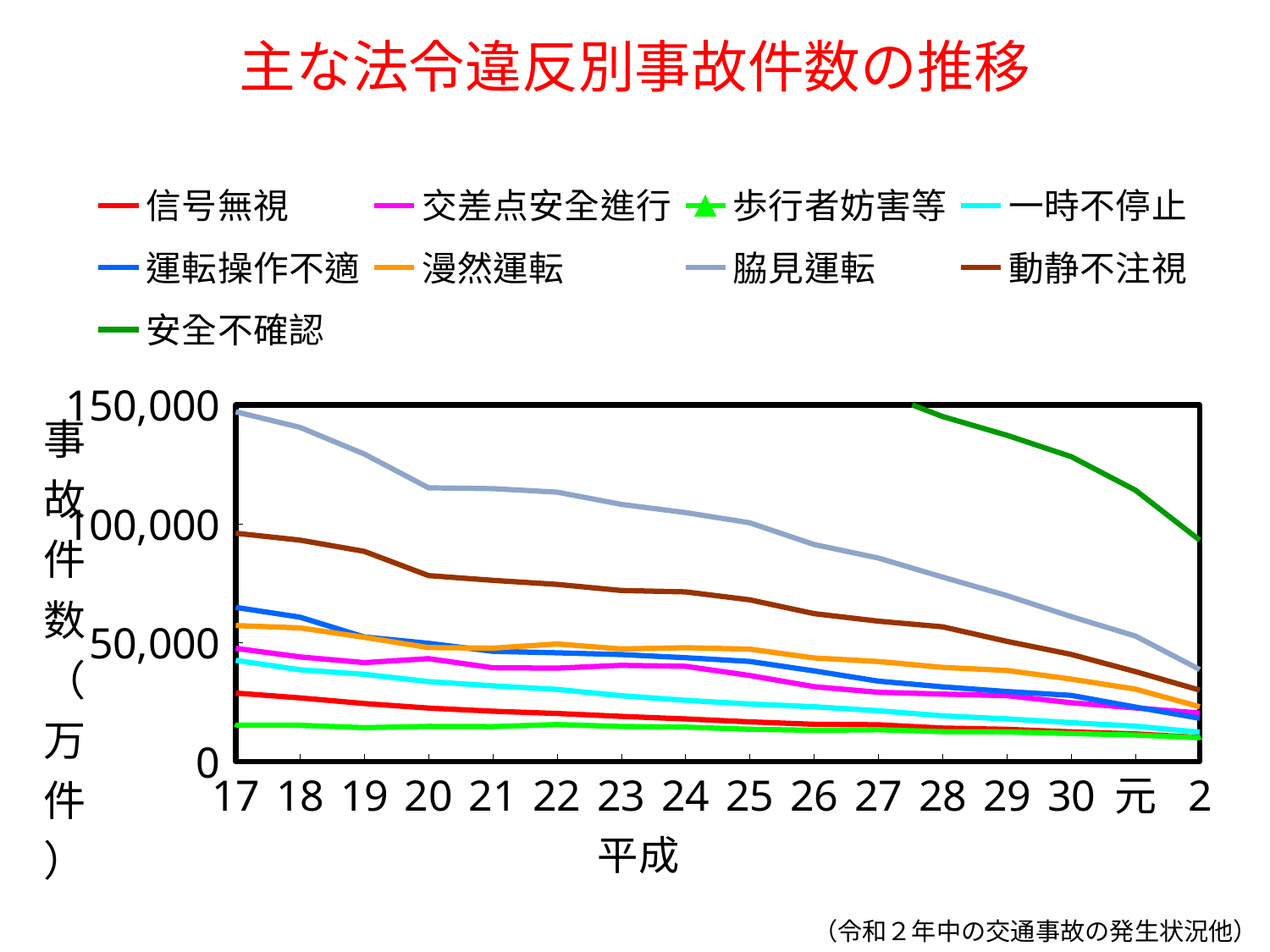
How many points are marked along the x axis? 16 Is the value for 安全不確認 in 平成30 greater or less than 100,000? greater Is the value for 運転操作不適 in 平成17 greater or less than 50,000? greater In 平成17, which is larger, 脇見運転 or 動静不注視? 脇見運転 Does the 脇見運転 line rise or fall from 平成17 to 令和2? fall What is the title of the chart? 主な法令違反別事故件数の推移 Is the value for 信号無視 in 平成17 greater or less than 50,000? less What kind of chart is shown on the slide? line chart Which series is drawn in red in the legend? 信号無視 How many series does the legend list? 9